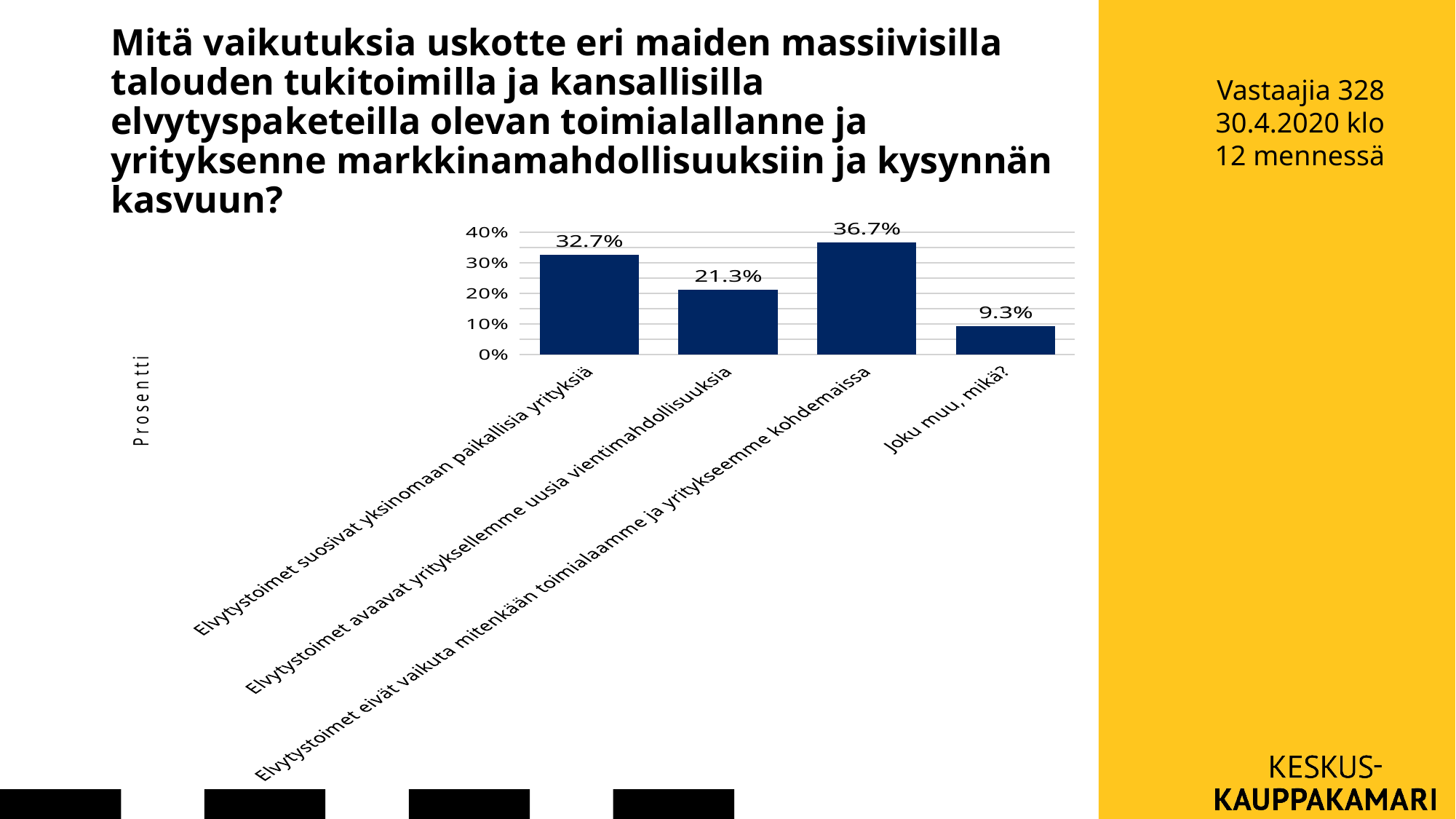
Is the value for "Elvytystoimet avaavat yrityksellemme uusia vientimahdollisuuksia" greater or less than 30%? less What is the difference between the values for "Elvytystoimet eivät vaikuta mitenkään toimialaamme ja yritykseemme kohdemaissa" and "Elvytystoimet suosivat yksinomaan paikallisia yrityksiä"? 4.0% What is the difference between the values for "Elvytystoimet suosivat yksinomaan paikallisia yrityksiä" and "Joku muu, mikä?"? 23.4% What is the value for "Elvytystoimet suosivat yksinomaan paikallisia yrityksiä"? 32.7% How many categories are shown in the chart? 4 What kind of chart is shown on the slide? bar chart What is the label of the vertical axis? Prosentti What is the value for "Elvytystoimet avaavat yrityksellemme uusia vientimahdollisuuksia"? 21.3% What is the value for "Joku muu, mikä?"? 9.3% Which is larger: the value for "Elvytystoimet avaavat yrityksellemme uusia vientimahdollisuuksia" or for "Joku muu, mikä?"? Elvytystoimet avaavat yrityksellemme uusia vientimahdollisuuksia Which category has the lowest value? Joku muu, mikä? Which category has the highest value? Elvytystoimet eivät vaikuta mitenkään toimialaamme ja yritykseemme kohdemaissa